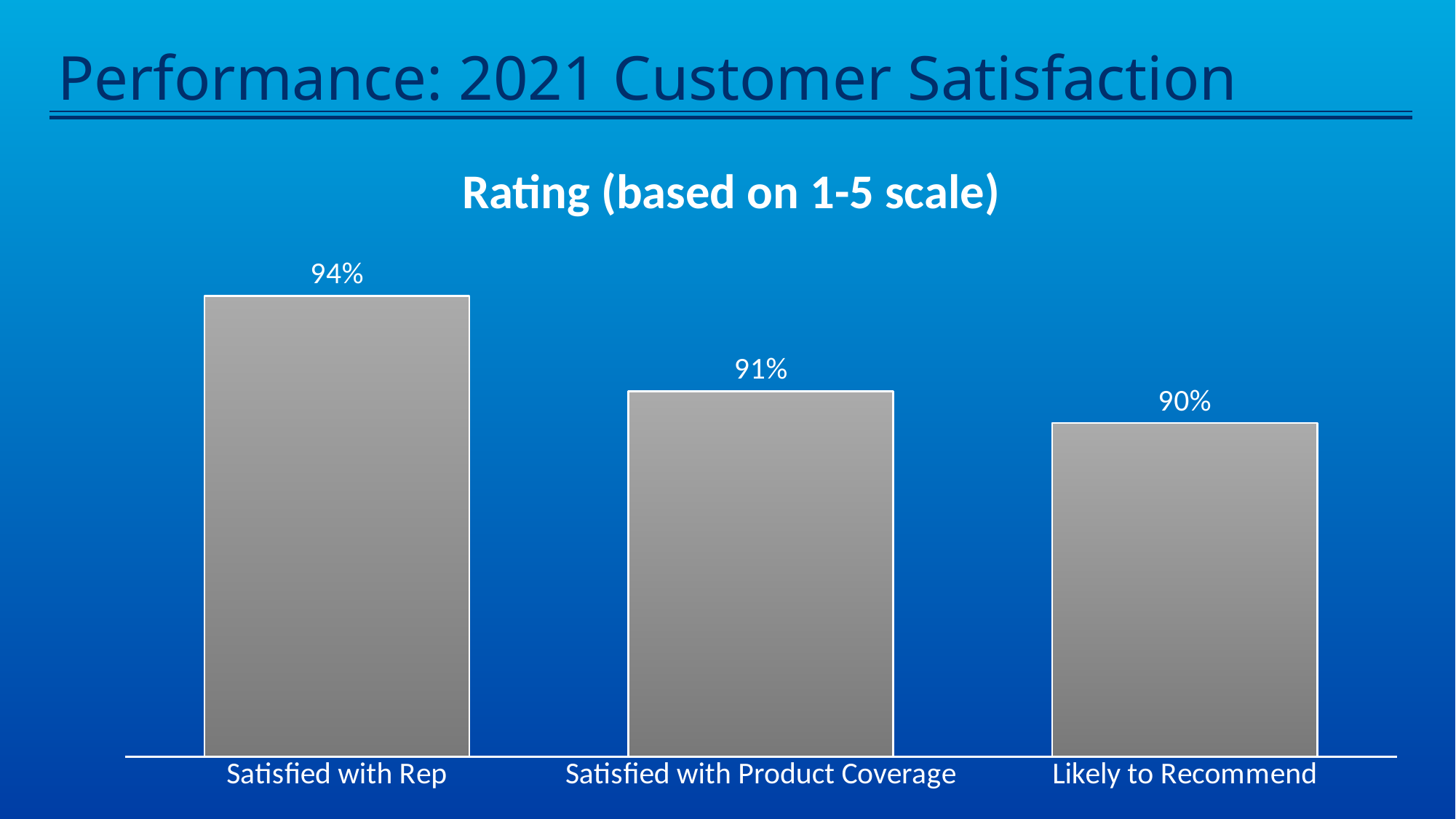
What is the value for Likely to Recommend? 90% Which is larger, the value for Satisfied with Product Coverage or the value for Likely to Recommend? Satisfied with Product Coverage Which category has the lowest value? Likely to Recommend What kind of chart is shown on the slide? Bar chart How many categories are shown in the chart? 3 What is the title of the chart? Rating (based on 1-5 scale) Do the values rise or fall from left to right across the categories? Fall Which category has the highest value? Satisfied with Rep What is the difference between the values for Satisfied with Rep and Satisfied with Product Coverage? 3% What is the value for Satisfied with Product Coverage? 91% What is the difference between the values for Satisfied with Rep and Likely to Recommend? 4% What is the value for Satisfied with Rep? 94%